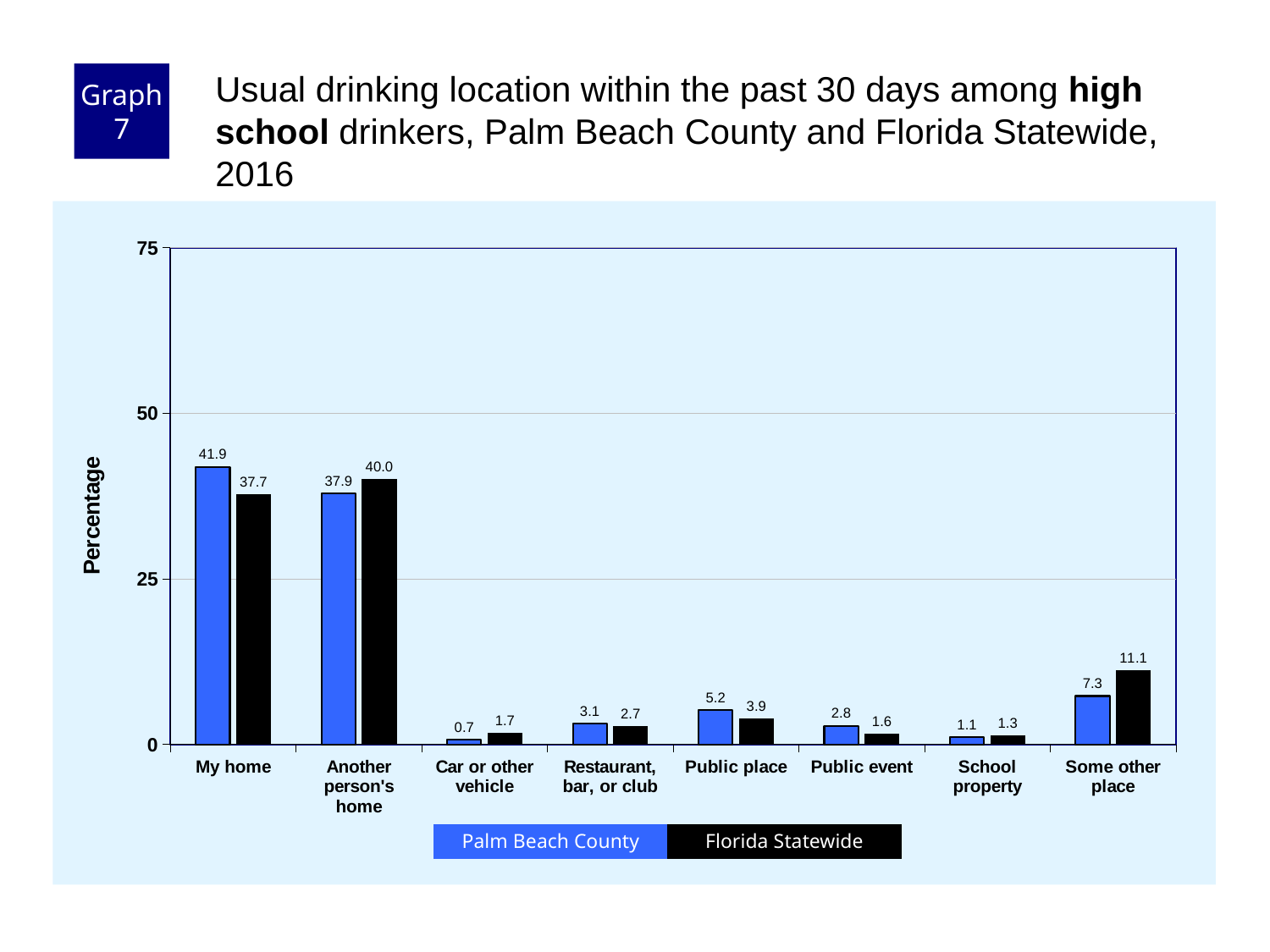
How many series does the legend list? 2 What is the difference between the Palm Beach County and Florida Statewide values for My home? 4.2 Which category has the highest Florida Statewide value? Another person's home What is the Florida Statewide value for Some other place? 11.1 Which is larger for Some other place: Palm Beach County or Florida Statewide? Florida Statewide How many categories are shown on the x axis? 8 Which category has the lowest Palm Beach County value? Car or other vehicle What is the label of the y axis? Percentage What is the Palm Beach County value for My home? 41.9 Is the Florida Statewide value for Another person's home greater or less than 25? greater What is the Palm Beach County value for Public place? 5.2 What kind of chart is shown on the slide? bar chart